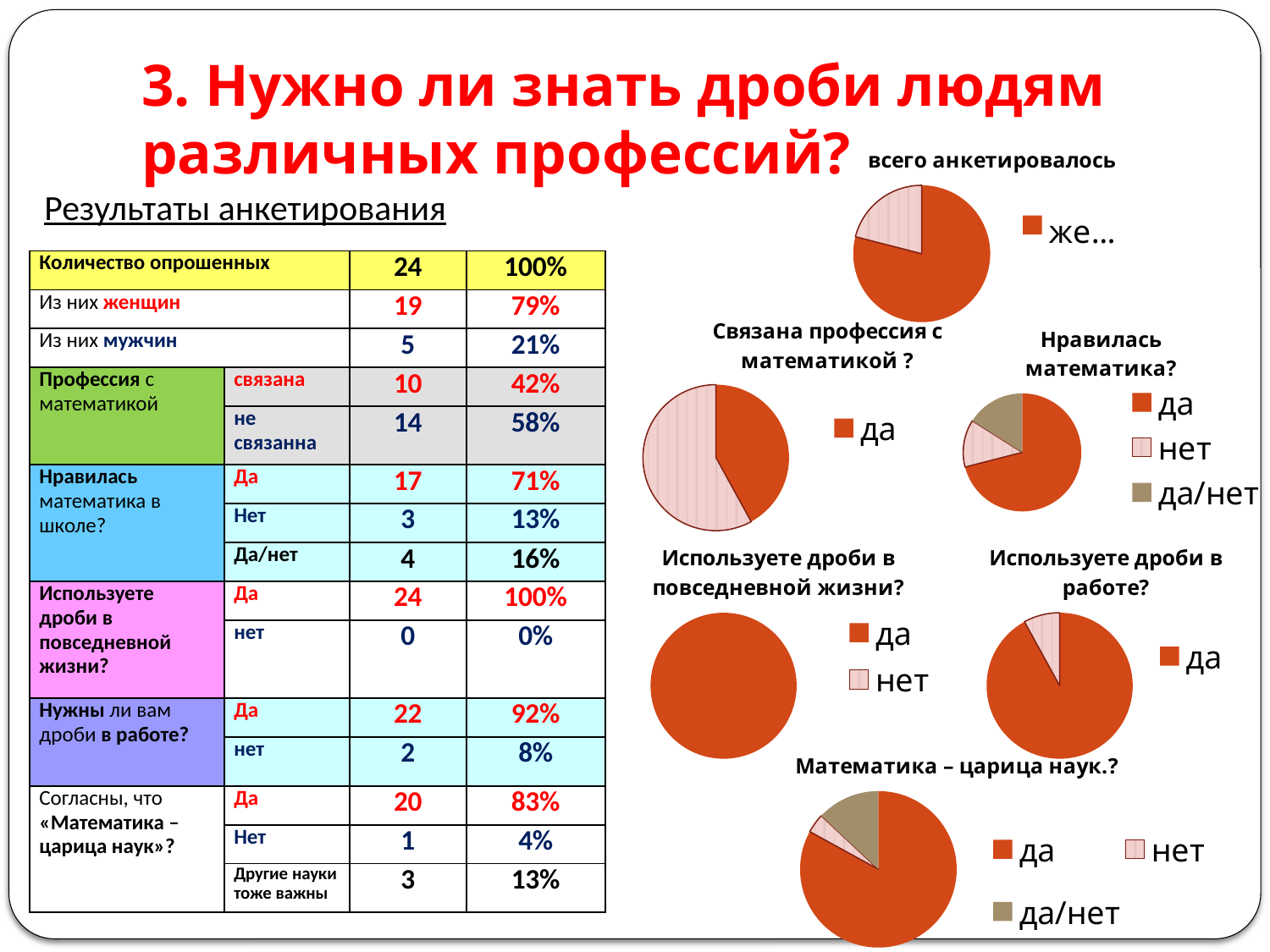
In the "Математика – царица наук.?" chart, which category has the largest slice? да What kind of chart is used for "Нравилась математика?"? pie chart In the "Связана профессия с математикой ?" chart, which slice is larger, the orange one or the pink one? pink What are the legend entries of the "Математика – царица наук.?" chart? да, нет, да/нет In the "Используете дроби в повседневной жизни?" chart, which category fills the entire pie? да In the "Используете дроби в повседневной жизни?" chart, how many entries does the legend list? 2 In the "Используете дроби в работе?" chart, what share of the pie does "да" take, according to the table on the slide? 92% How many pie charts are shown on the slide? 6 In the "Математика – царица наук.?" chart, how many entries does the legend list? 3 In the "Математика – царица наук.?" chart, which category has the smallest slice? нет In the "Нравилась математика?" chart, which category has the largest slice? да In the "Нравилась математика?" chart, how many entries does the legend list? 3